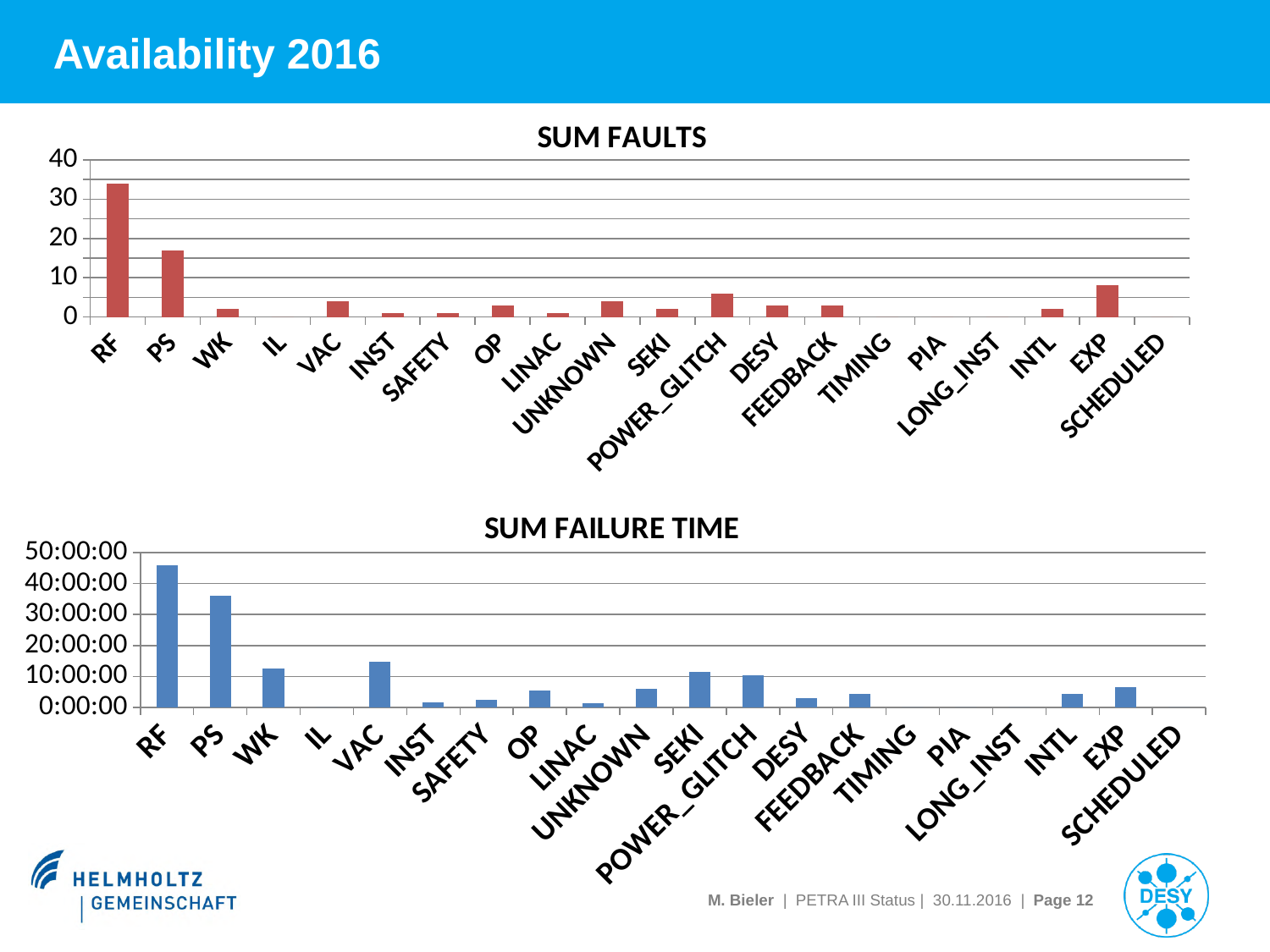
In the SUM FAULTS chart, which is larger, the value for PS or the value for VAC? PS In the SUM FAULTS chart, which category has the highest value? RF In the SUM FAULTS chart, is the value for EXP greater or less than 10? less In the SUM FAILURE TIME chart, which category has the highest value? RF In the SUM FAILURE TIME chart, which is larger, the value for RF or the value for PS? RF How many categories are shown on the x axis of the SUM FAULTS chart? 20 What is the title of the lower chart on the slide? SUM FAILURE TIME In the SUM FAULTS chart, is the value for RF greater or less than 30? greater What kind of chart is the SUM FAULTS chart? bar chart In the SUM FAILURE TIME chart, is the value for VAC greater or less than 10:00:00? greater